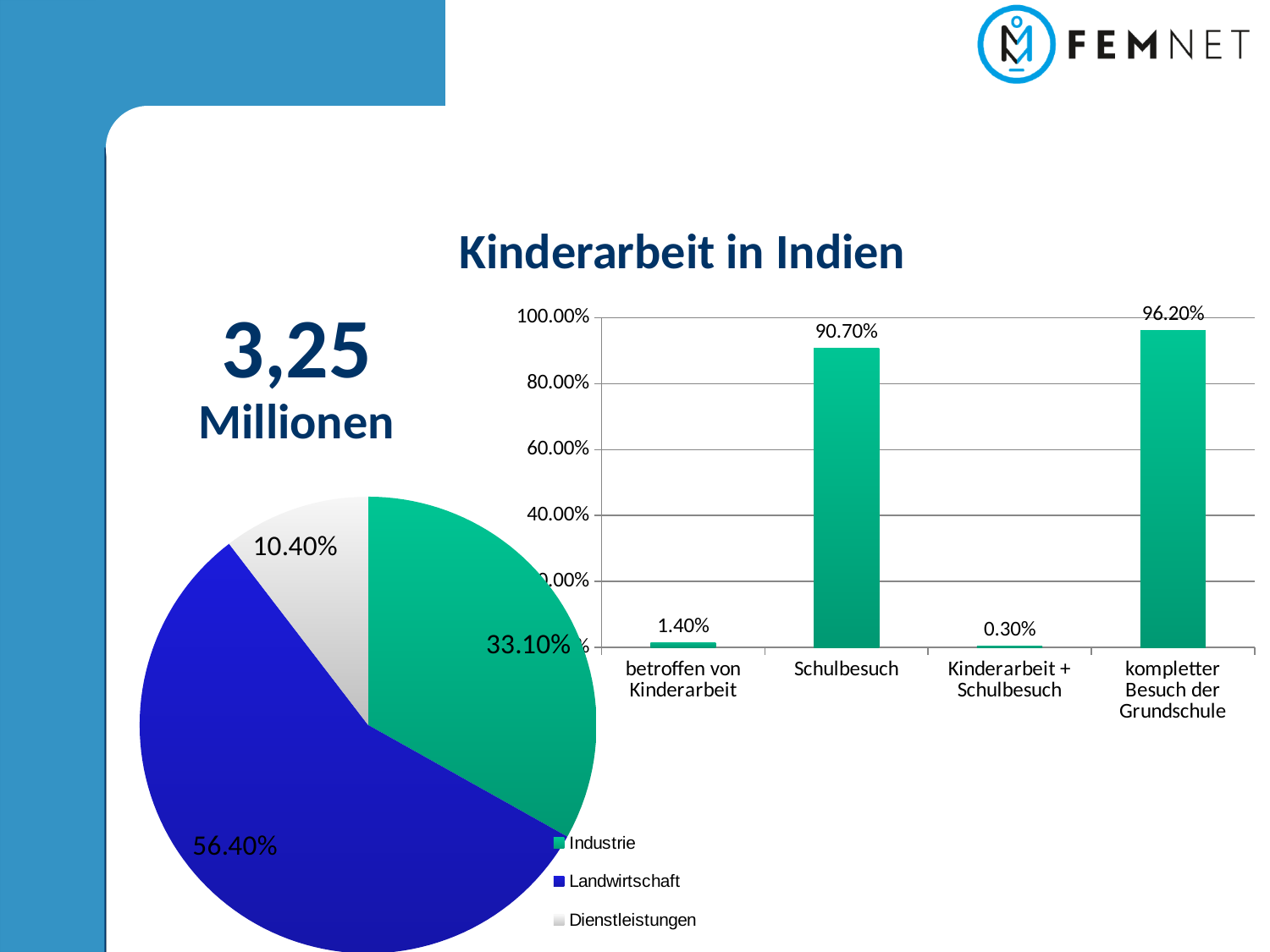
What type of chart is the chart titled 'Kinderarbeit in Indien'? bar chart In the pie chart on the left, which is larger: 'Industrie' or 'Dienstleistungen'? Industrie In the bar chart 'Kinderarbeit in Indien', what is the value for 'betroffen von Kinderarbeit'? 1.40% In the bar chart 'Kinderarbeit in Indien', what is the value for 'Schulbesuch'? 90.70% In the pie chart on the left, what share does 'Landwirtschaft' have? 56.40% In the bar chart 'Kinderarbeit in Indien', what is the difference between 'kompletter Besuch der Grundschule' and 'Schulbesuch'? 5.50% In the bar chart 'Kinderarbeit in Indien', is the value for 'Schulbesuch' greater or less than 80.00%? greater In the bar chart 'Kinderarbeit in Indien', which category has the highest value? kompletter Besuch der Grundschule In the bar chart 'Kinderarbeit in Indien', which category has the lowest value? Kinderarbeit + Schulbesuch In the bar chart 'Kinderarbeit in Indien', how many categories are shown on the x axis? 4 In the pie chart on the left, which slice is the largest? Landwirtschaft In the pie chart on the left, what is the value for 'Dienstleistungen'? 10.40%